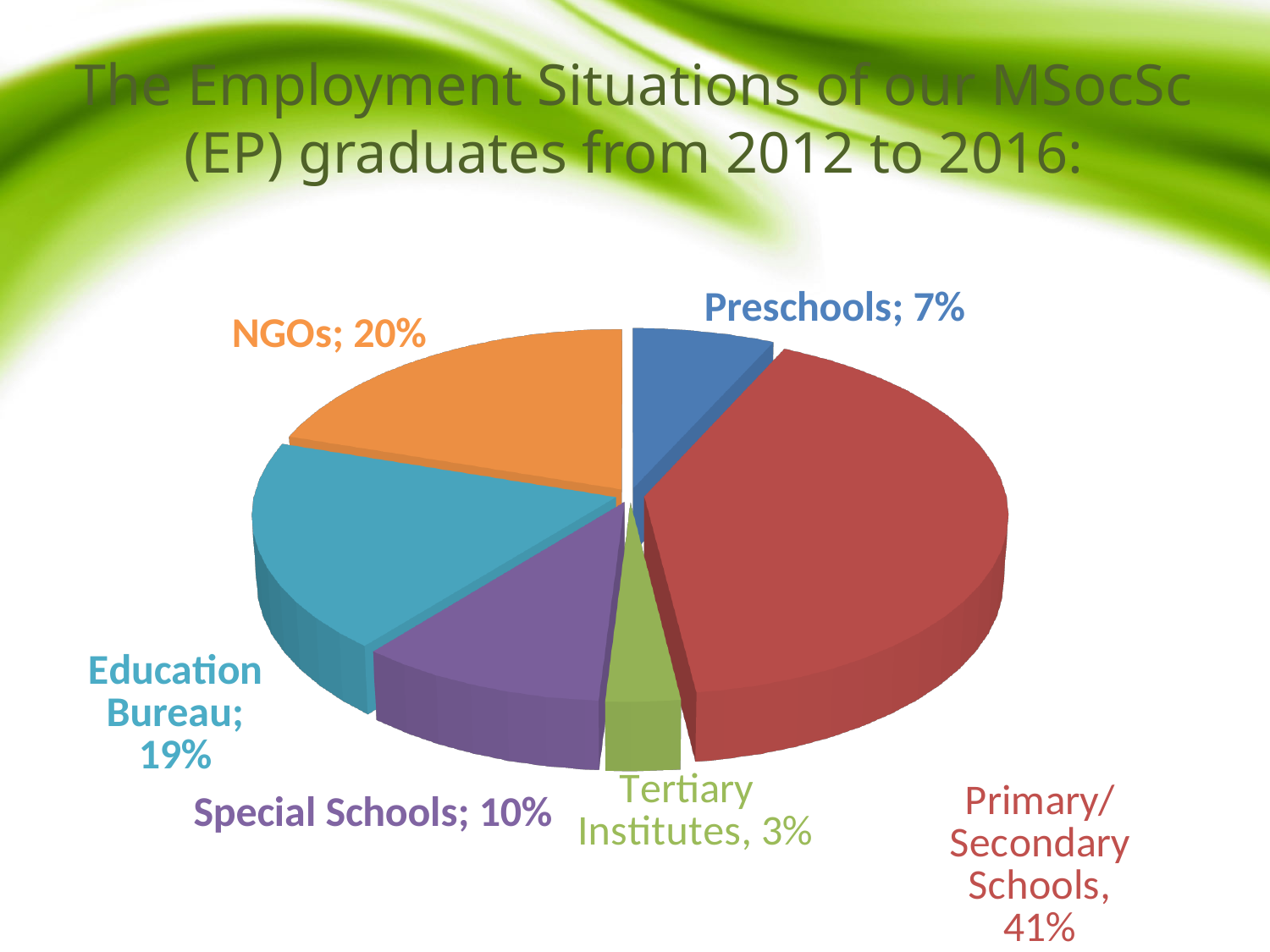
What percentage of graduates are employed in NGOs? 20% Which employment category has the smallest share of the pie? Tertiary Institutes What type of chart is shown on the slide? Pie chart What percentage of graduates are employed in Preschools? 7% What percentage of graduates are employed in Tertiary Institutes? 3% What percentage of graduates are employed in Primary/Secondary Schools? 41% What is the difference in percentage points between NGOs and Education Bureau? 1% What is the difference in percentage points between Primary/Secondary Schools and Special Schools? 31% Which employment category has the largest share of the pie? Primary/Secondary Schools What colour is the slice for Education Bureau? Teal/blue How many employment categories are shown in the pie chart? 6 Which has a larger share, Special Schools or Preschools? Special Schools